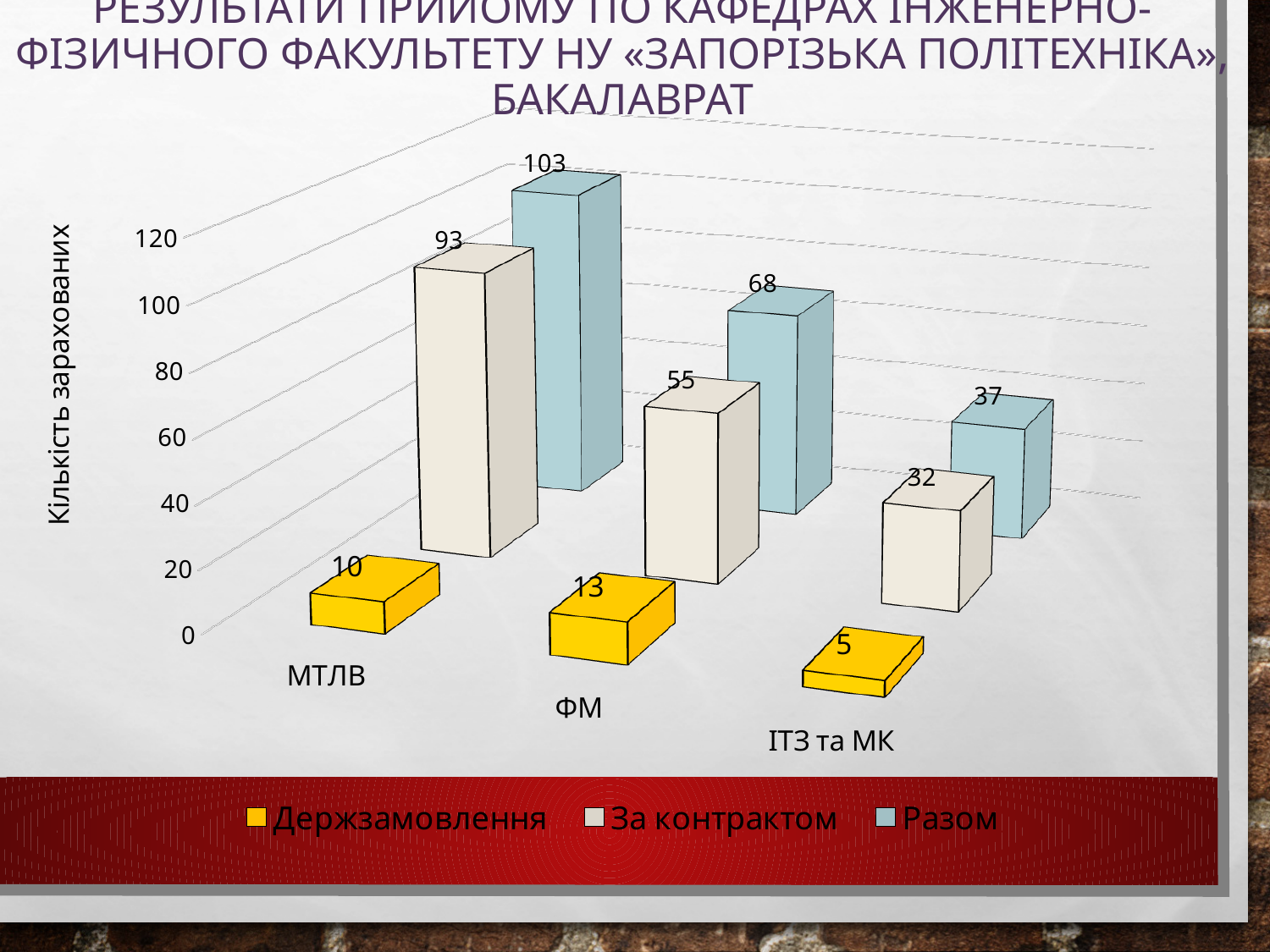
What is the value of За контрактом for ФМ? 55 What is the difference between the За контрактом values for МТЛВ and ФМ? 38 What is the value of Разом for МТЛВ? 103 What is the label of the vertical axis? Кількість зарахованих Which is larger: Держзамовлення for ФМ or Держзамовлення for МТЛВ? Держзамовлення for ФМ What kind of chart is shown on the slide? Bar chart How many categories are shown on the x axis? 3 Do the Разом values rise or fall from МТЛВ to ІТЗ та МК? Fall How many series does the legend list? 3 Which category has the lowest Держзамовлення value? ІТЗ та МК What is the value of Держзамовлення for ІТЗ та МК? 5 Which category has the highest Разом value? МТЛВ